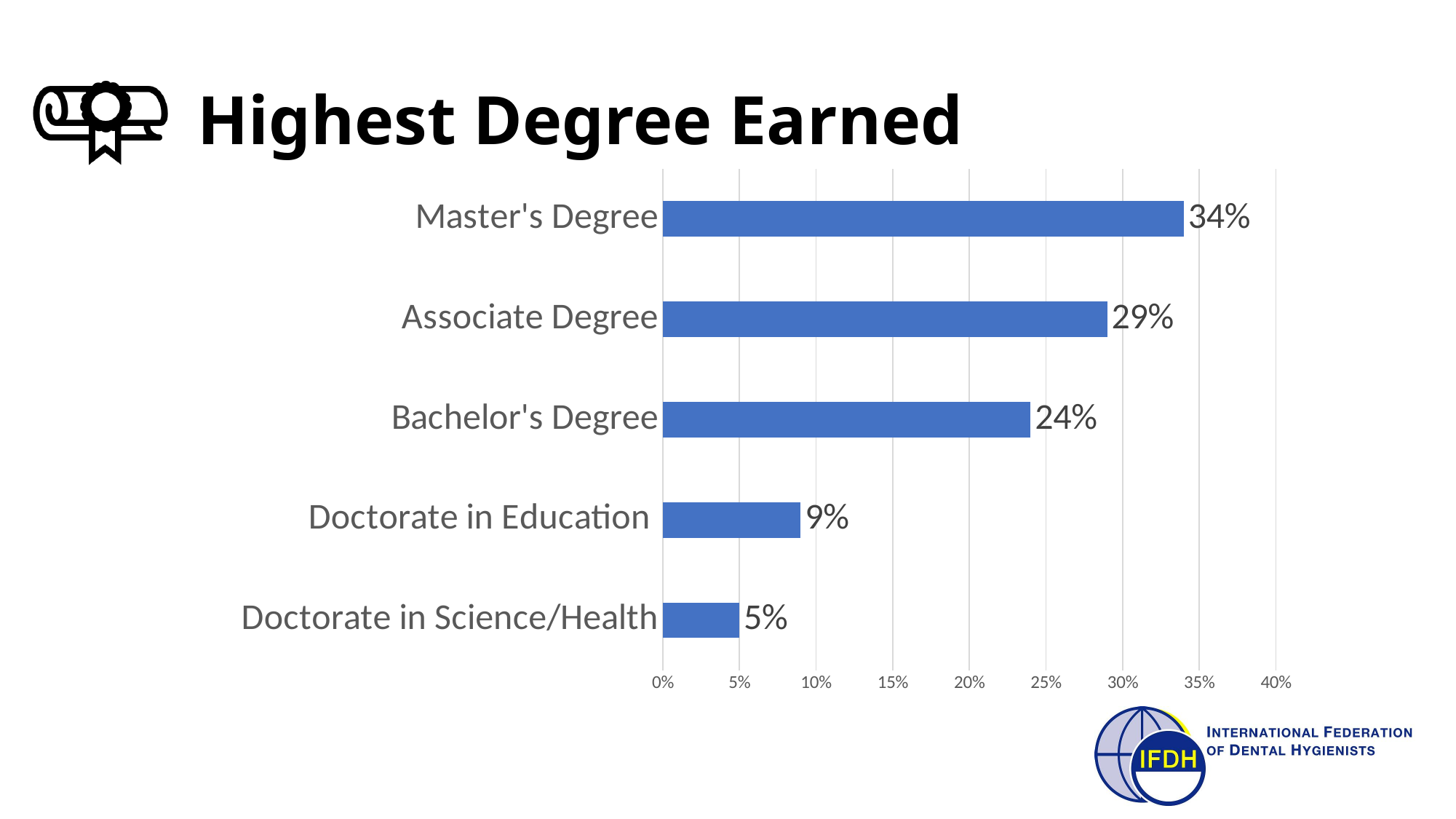
What is the value shown for Bachelor's Degree? 24% Which is larger, the value for Associate Degree or the value for Bachelor's Degree? Associate Degree What type of chart is shown on the slide? Bar chart What is the title of the slide? Highest Degree Earned How many degree categories are shown in the chart? 5 What is the difference between the Master's Degree value and the Bachelor's Degree value? 10% Which degree category has the lowest value? Doctorate in Science/Health Which degree category has the highest value? Master's Degree What percentage of respondents reported a Master's Degree as their highest degree earned? 34% What percentage is shown for Doctorate in Education? 9% What is the value shown for Associate Degree? 29% What percentage is shown for Doctorate in Science/Health? 5%